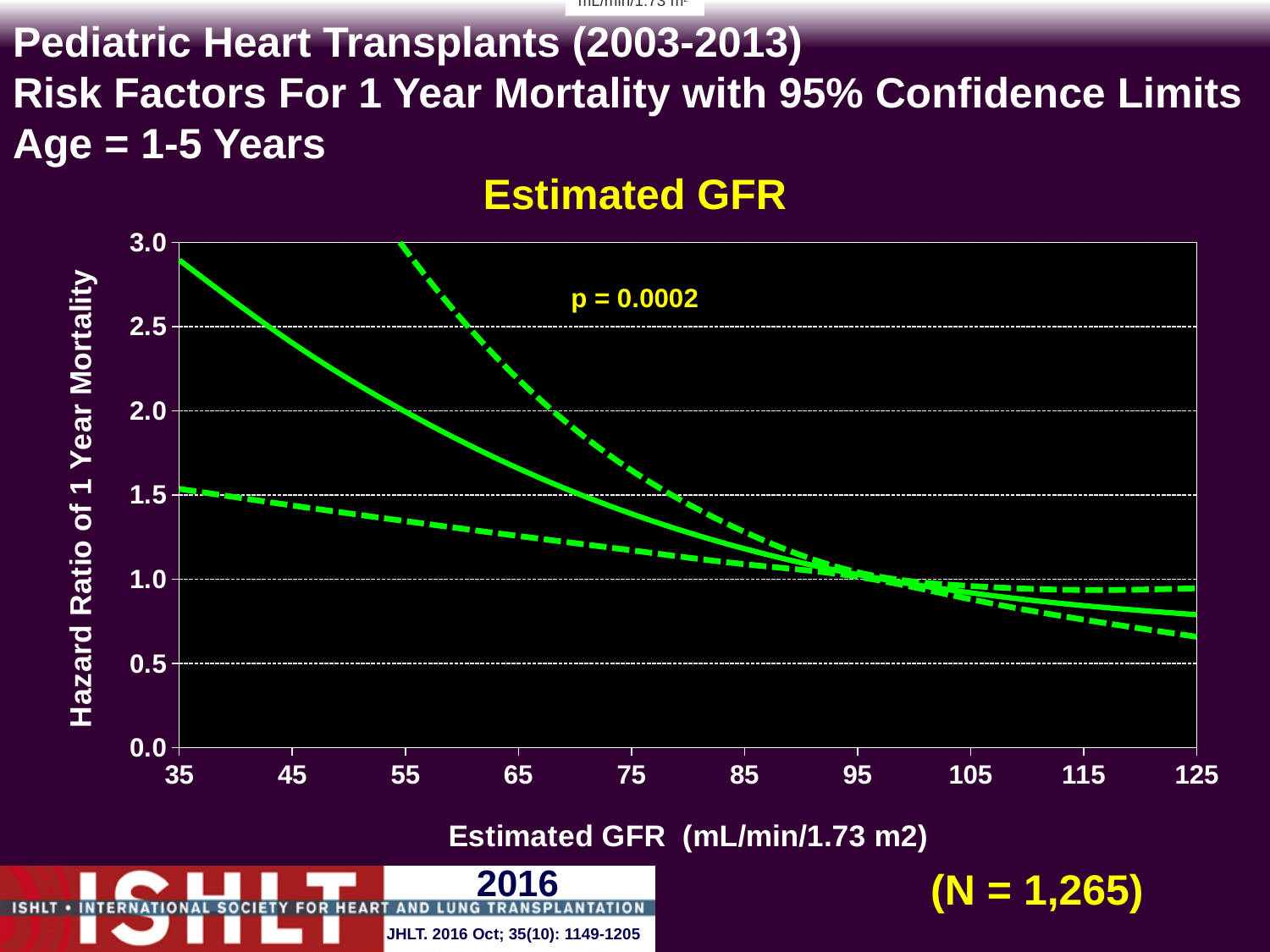
What is the title shown above the chart? Estimated GFR Is the lower dashed confidence limit at an Estimated GFR of 55 greater or less than 1.5? less Is the hazard ratio on the solid line at an Estimated GFR of 75 greater or less than 1.0? greater Does the solid hazard ratio line rise or fall as Estimated GFR increases along the x axis? fall Is the hazard ratio on the solid line at an Estimated GFR of 125 greater or less than 1.0? less What kind of chart is shown on the slide? line chart How many lines are plotted on the chart? 3 Which has the higher hazard ratio on the solid line: an Estimated GFR of 45 or an Estimated GFR of 105? 45 What is the label of the y axis? Hazard Ratio of 1 Year Mortality